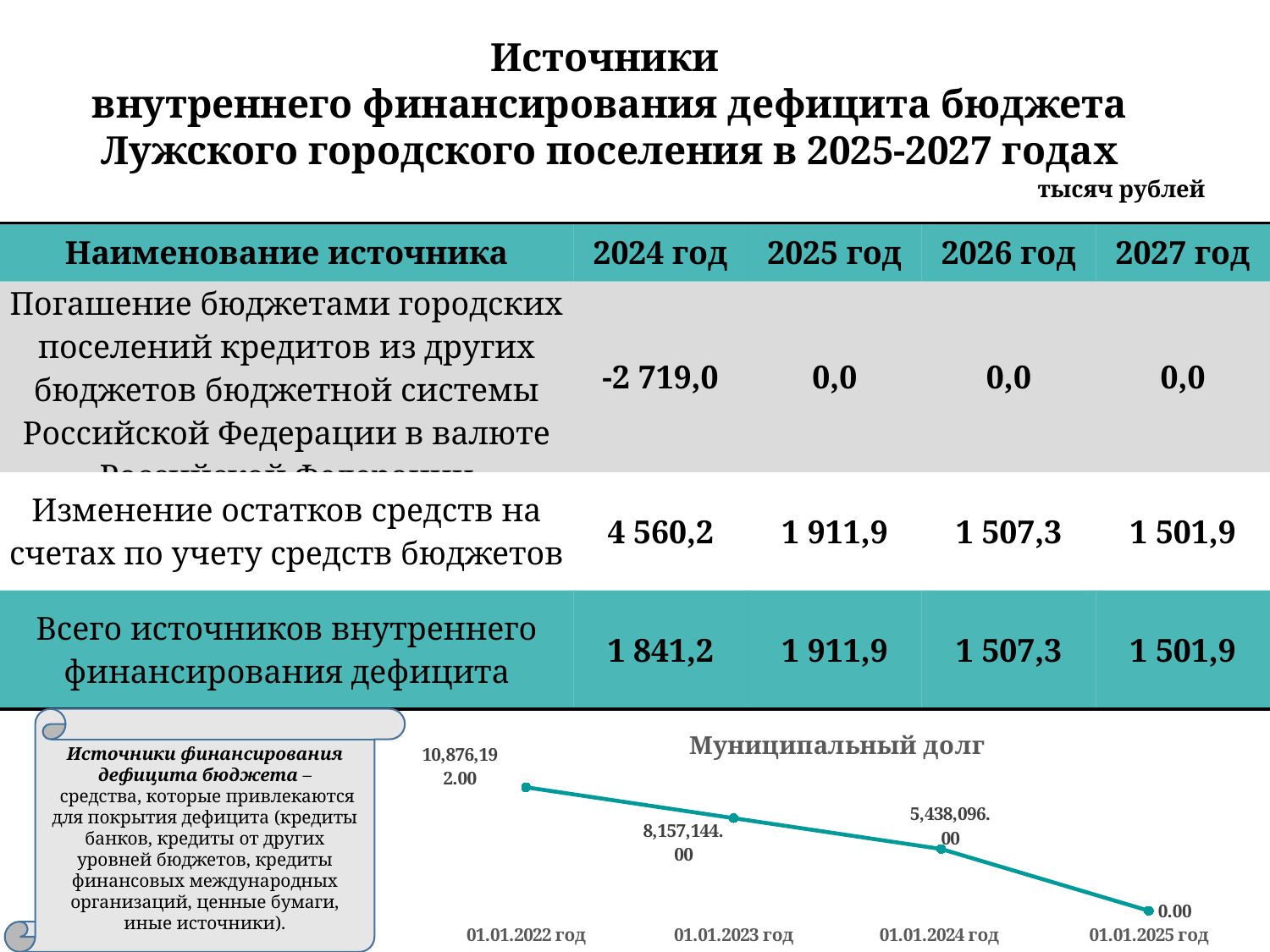
In the "Муниципальный долг" chart, which is larger: the value for 01.01.2023 год or the value for 01.01.2024 год? 01.01.2023 год In the "Муниципальный долг" chart, what is the difference between the values for 01.01.2022 год and 01.01.2023 год? 2,719,048.00 What kind of chart is the "Муниципальный долг" chart? line chart In the "Муниципальный долг" chart, do the values rise or fall from 01.01.2022 год to 01.01.2025 год? fall In the "Муниципальный долг" chart, which date has the lowest value? 01.01.2025 год In the "Муниципальный долг" chart, which date has the highest value? 01.01.2022 год In the "Муниципальный долг" chart, what is the value for 01.01.2025 год? 0.00 In the "Муниципальный долг" chart, what is the value for 01.01.2023 год? 8,157,144.00 In the "Муниципальный долг" chart, what is the value for 01.01.2024 год? 5,438,096.00 What is the title of the chart on the slide? Муниципальный долг In the "Муниципальный долг" chart, how many data points are plotted? 4 In the "Муниципальный долг" chart, what is the value for 01.01.2022 год? 10,876,192.00